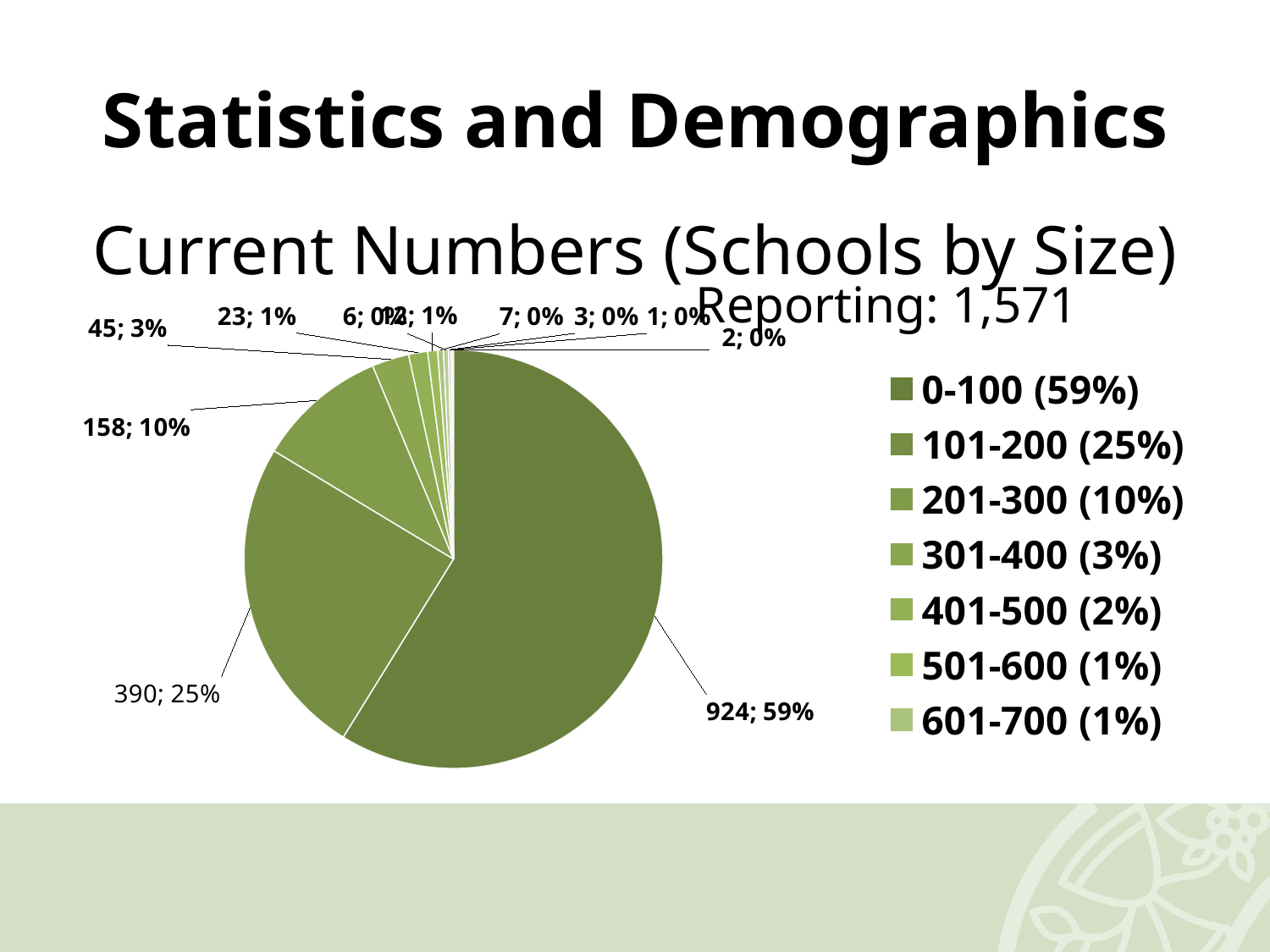
How many schools are in the 201-300 size category? 158 How many schools are in the 101-200 size category? 390 How many schools are in the 0-100 size category? 924 What share of the pie does the 101-200 category represent? 25% How many schools are in the 301-400 size category? 45 How many schools are reported in total according to the chart title? 1,571 What is the difference between the number of schools in the 0-100 category and the 101-200 category? 534 How many categories are listed in the chart's legend? 7 What kind of chart is shown on the slide? pie chart Which category has more schools, 201-300 or 301-400? 201-300 Which school size category has the largest slice of the pie? 0-100 What share of the pie does the 0-100 category represent? 59%